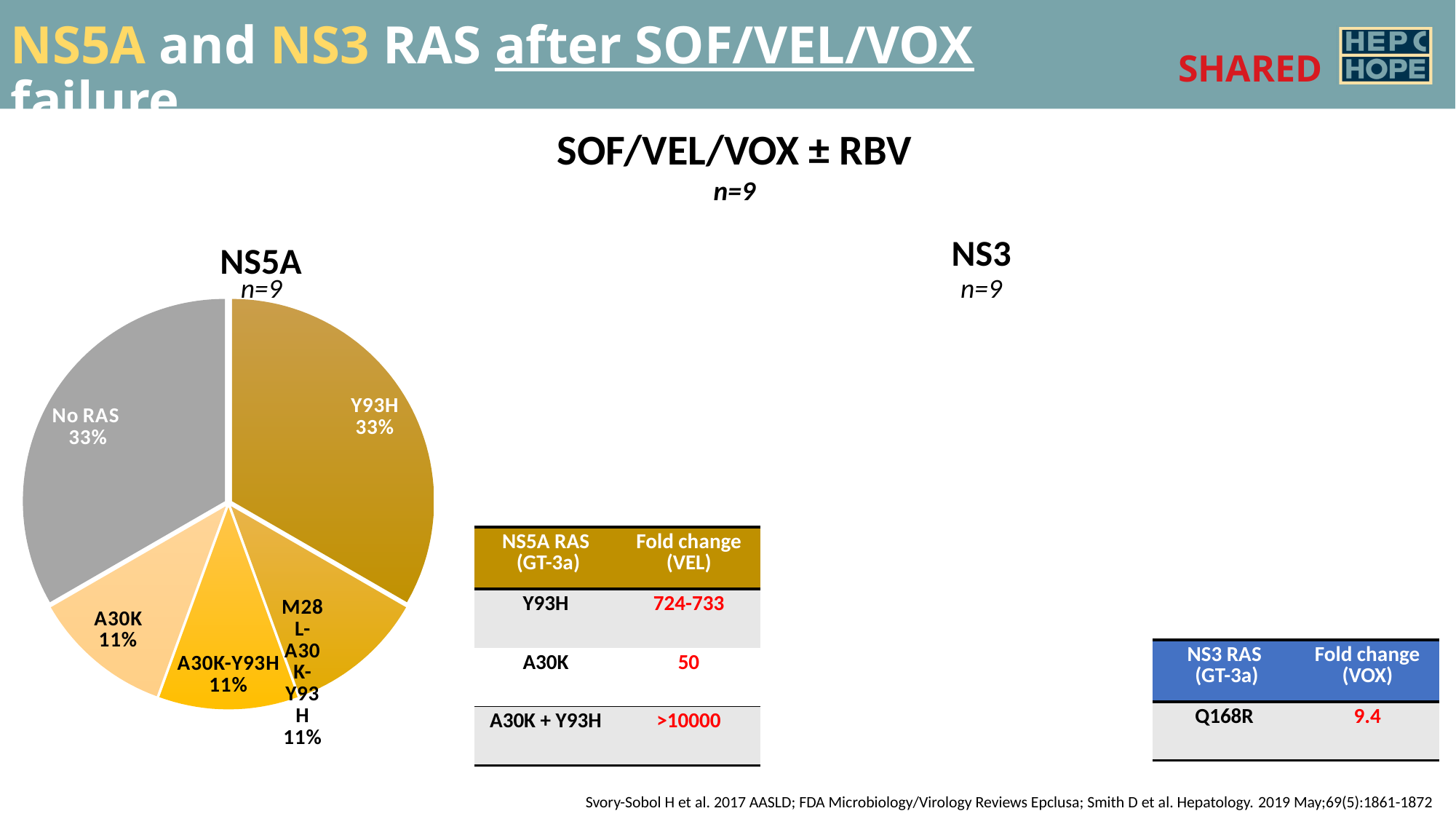
What kind of chart is the NS5A chart on the slide? pie chart In the NS5A pie chart, what is the difference in percentage points between the Y93H slice and the A30K-Y93H slice? 22 In the NS5A pie chart, what percentage is shown for A30K? 11% In the NS5A pie chart, what share of the pie is the Y93H slice? 33% In the NS5A pie chart, what is the combined percentage of the Y93H and No RAS slices? 66% In the NS5A pie chart, what colour is the No RAS slice? grey In the NS5A pie chart, what percentage is shown for M28L-A30K-Y93H? 11% How many slices does the NS5A pie chart have? 5 In the NS5A pie chart, what percentage is shown for No RAS? 33% In the NS5A pie chart, what percentage is shown for A30K-Y93H? 11% In the NS5A pie chart, which is larger, the Y93H slice or the A30K slice? Y93H What sample size (n) is shown under the NS5A pie chart title? n=9